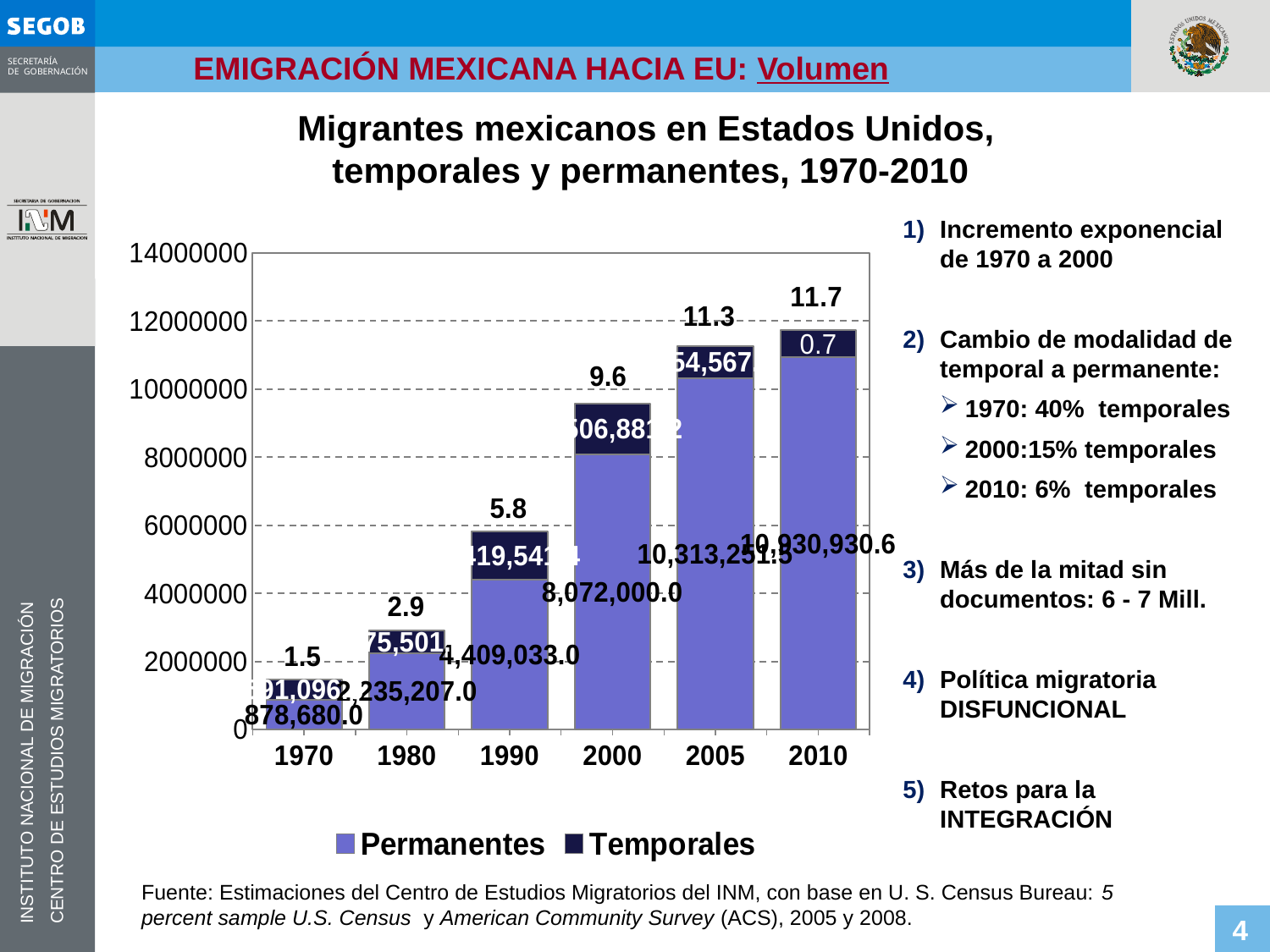
What is the difference between the Permanentes values for 2000 and 1990? 3,662,967.0 What kind of chart is shown on the slide? Stacked bar chart What is the value of Permanentes for 2010? 10,930,930.6 What is the value of Permanentes for 2000? 8,072,000.0 How many series does the chart legend list? 2 Which year has the highest total bar in the chart? 2010 How many years (categories) are shown on the x axis of the chart? 6 What is the value of Permanentes for 1970? 878,680.0 Do the total bar values rise or fall from 1970 to 2010? Rise Which two series are listed in the chart legend? Permanentes and Temporales Is the total value for 1990 greater or less than 4000000? greater Which year has the lowest total bar in the chart? 1970